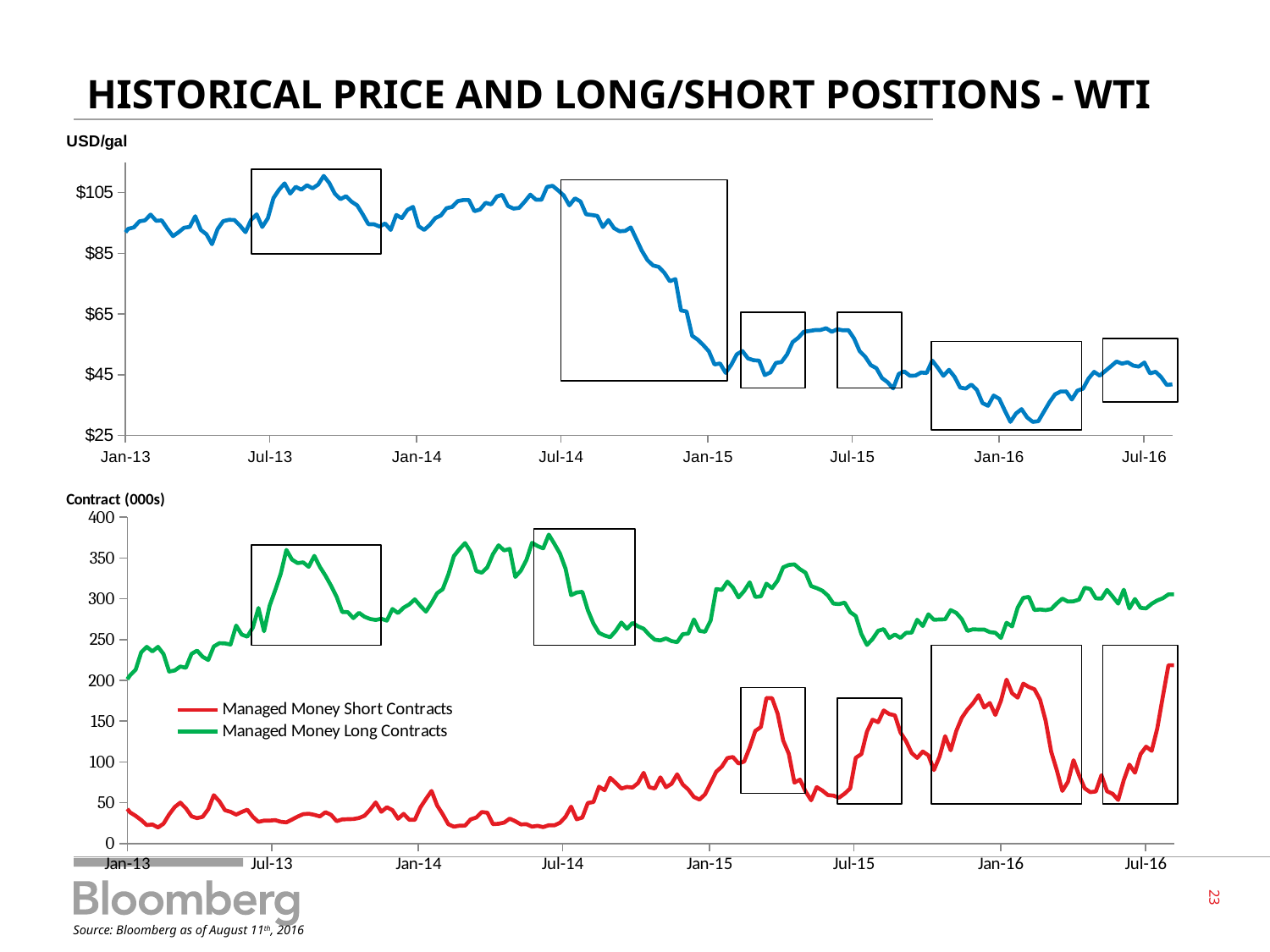
In the bottom chart (Contract (000s)), is the Managed Money Short Contracts value at Jan-13 greater or less than 100? less In the bottom chart (Contract (000s)), is the Managed Money Long Contracts value at Jul-16 greater or less than 250? greater What kind of chart is the top chart (USD/gal)? line chart In the top chart (USD/gal), is the value at Jan-13 greater or less than $85? greater In the bottom chart (Contract (000s)), what colour is the Managed Money Short Contracts line? red What is the y-axis label of the top chart? USD/gal In the bottom chart (Contract (000s)), which series has the higher value at Jan-14: Managed Money Short Contracts or Managed Money Long Contracts? Managed Money Long Contracts How many series does the legend of the bottom chart (Contract (000s)) list? 2 In the top chart (USD/gal), which is higher: the value at Jan-14 or the value at Jan-16? Jan-14 In the top chart (USD/gal), does the price rise or fall between Jul-14 and Jan-15? fall